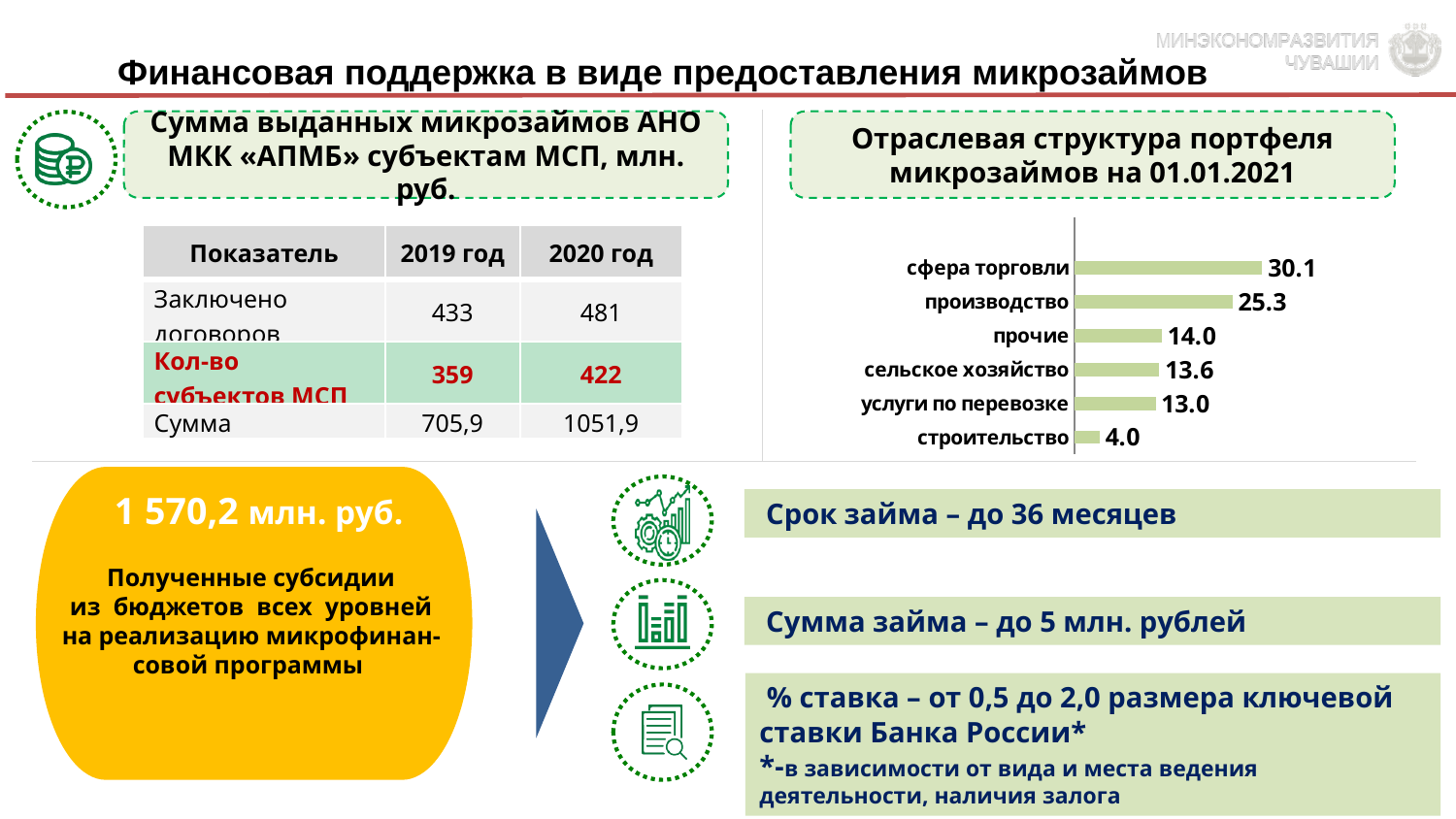
Which is larger, the value for производство or the value for прочие? производство What is the difference between the values for сфера торговли and производство? 4.8 What kind of chart is shown on the slide? bar chart What is the value for сфера торговли in the chart? 30.1 How many categories are shown in the chart? 6 What is the value for сельское хозяйство in the chart? 13.6 Which category has the lowest value in the chart? строительство What is the difference between the values for прочие and строительство? 10.0 What is the title of the chart? Отраслевая структура портфеля микрозаймов на 01.01.2021 Which category has the highest value in the chart? сфера торговли What is the value for производство in the chart? 25.3 What is the value for строительство in the chart? 4.0